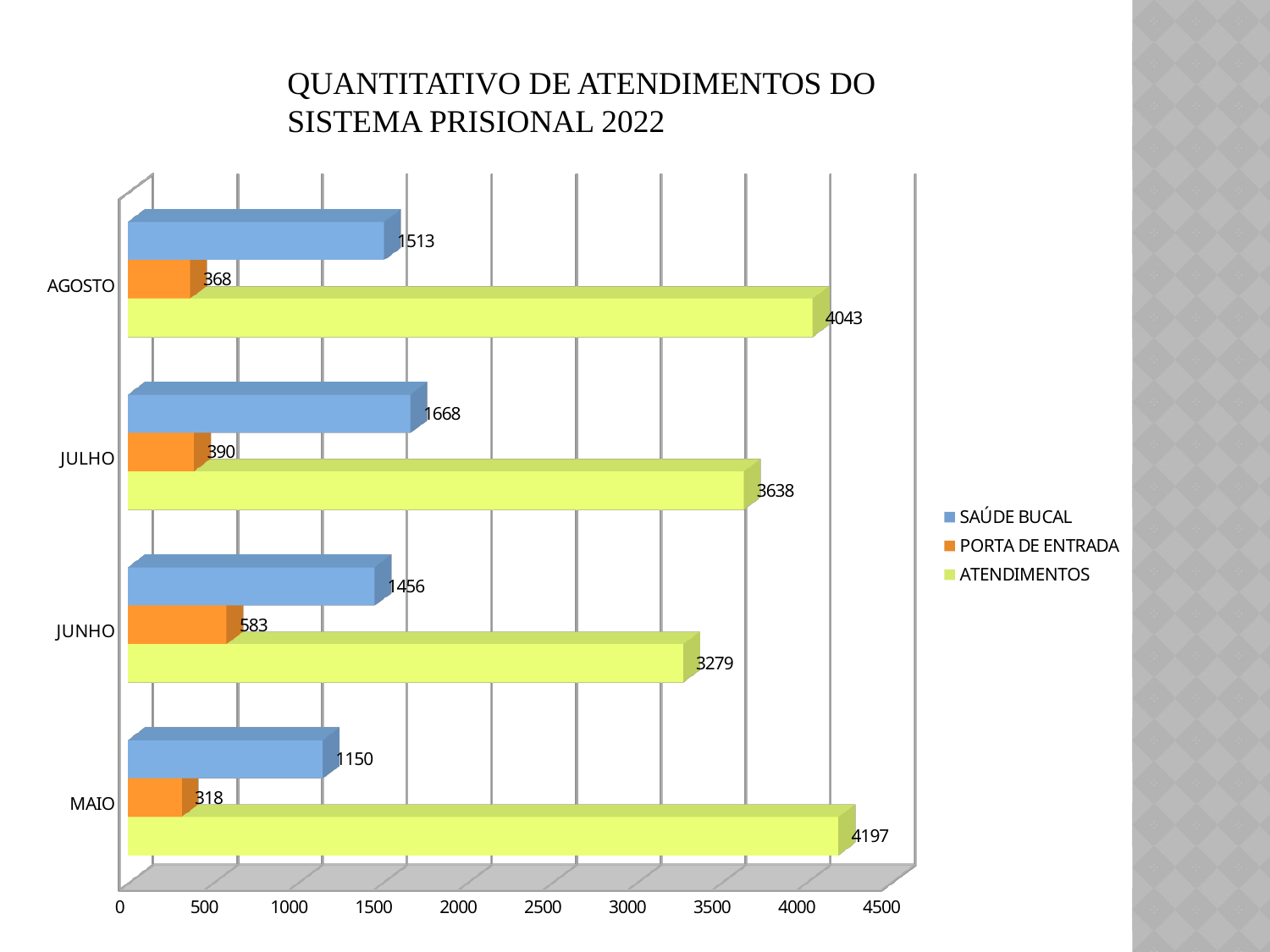
What kind of chart is shown on the slide? bar chart What is the title of the chart? QUANTITATIVO DE ATENDIMENTOS DO SISTEMA PRISIONAL 2022 Which month has the lowest SAÚDE BUCAL value? MAIO What is the value for SAÚDE BUCAL in JULHO? 1668 What is the value for ATENDIMENTOS in MAIO? 4197 Which month has the highest ATENDIMENTOS value? MAIO Is the value for ATENDIMENTOS in JUNHO greater or less than 3500? less How many months are shown on the chart? 4 How many series does the legend list? 3 Which is larger, the PORTA DE ENTRADA value for JULHO or for AGOSTO? JULHO What is the value for PORTA DE ENTRADA in JUNHO? 583 What is the difference between the ATENDIMENTOS values for AGOSTO and JULHO? 405